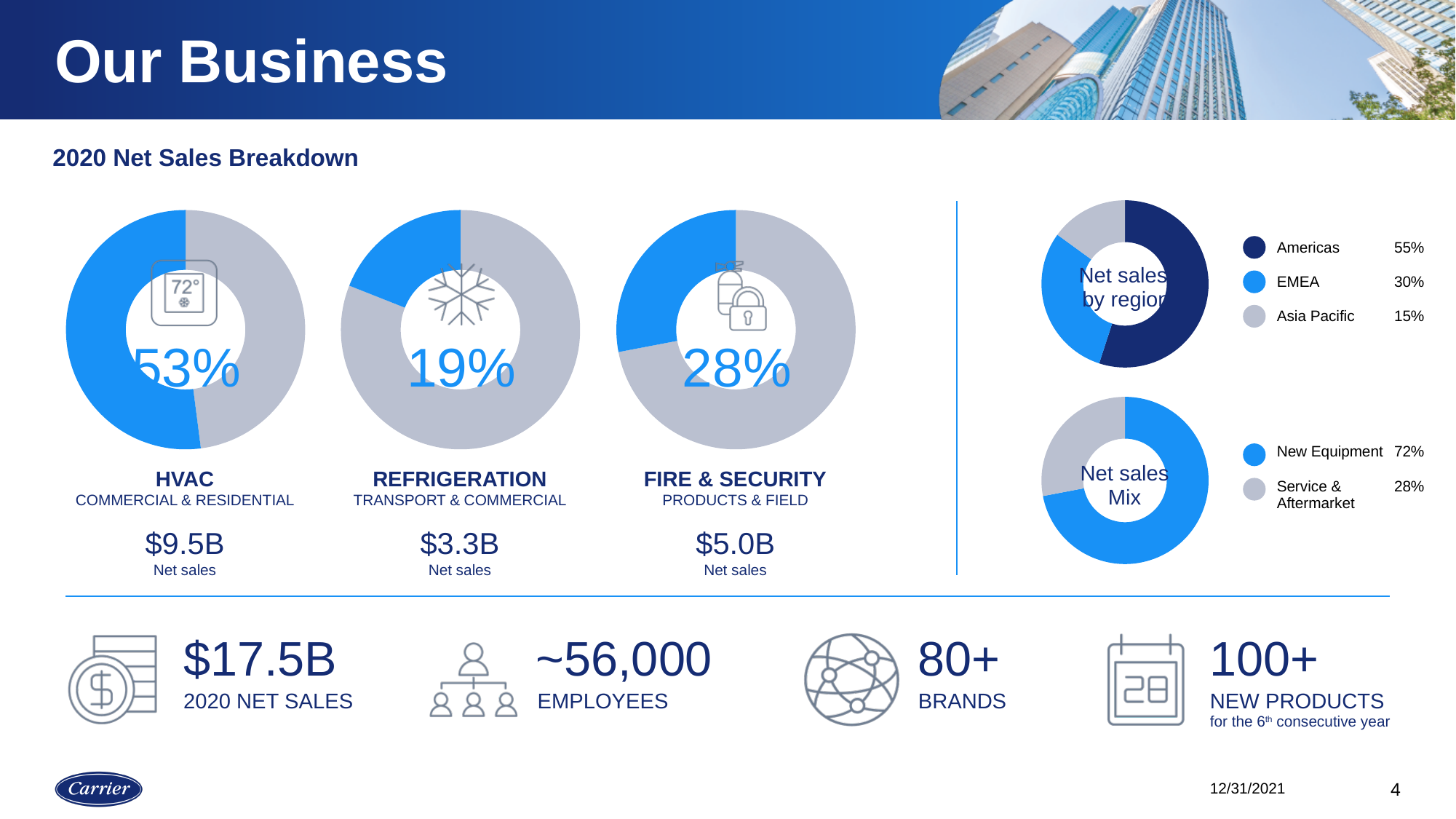
In the 'Net sales by region' chart, which region has the largest share? Americas In the 'Net sales Mix' chart, which category is larger, New Equipment or Service & Aftermarket? New Equipment In the 'Net sales Mix' chart, what share of net sales is New Equipment? 72% In the 'Net sales Mix' chart, what share of net sales is Service & Aftermarket? 28% In the Refrigeration donut chart, what percentage of net sales does Refrigeration represent? 19% In the HVAC donut chart on the left, what percentage of net sales does HVAC represent? 53% What type of chart is used to show 'Net sales by region'? Donut (pie) chart In the 'Net sales by region' chart, what share of net sales comes from the Americas? 55% In the 'Net sales by region' chart, which region has the smallest share? Asia Pacific In the 'Net sales by region' chart, how many regions are shown in the legend? 3 In the 'Net sales by region' chart, what share of net sales comes from EMEA? 30% In the 'Net sales by region' chart, what is the difference in percentage points between the Americas and EMEA shares? 25%